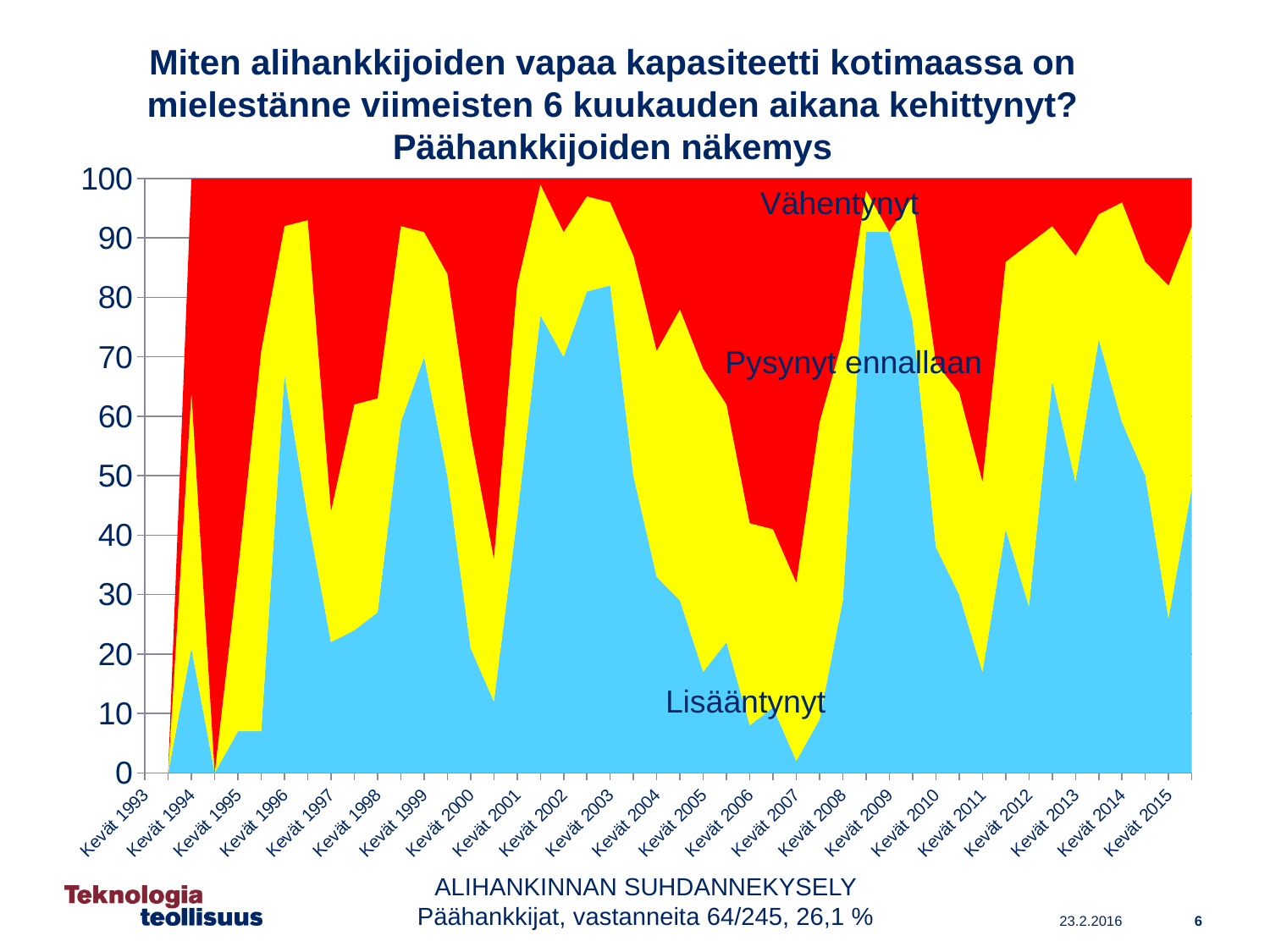
How many labelled points are there on the x axis of the chart? 23 Is the value for Lisääntynyt at Kevät 1996 greater or less than 50? greater Is the value for Lisääntynyt at Kevät 2003 greater or less than 70? greater Is the Lisääntynyt value larger at Kevät 2009 or at Kevät 2011? Kevät 2009 How many series are shown in the chart? 3 What colour is the Vähentynyt series in the chart? Red In which year does the Lisääntynyt series reach its highest value? Kevät 2009 Is the value for Lisääntynyt at Kevät 2009 greater or less than 80? greater Which series is plotted at the bottom of the stacked area chart? Lisääntynyt What kind of chart is shown on the slide? Stacked area chart